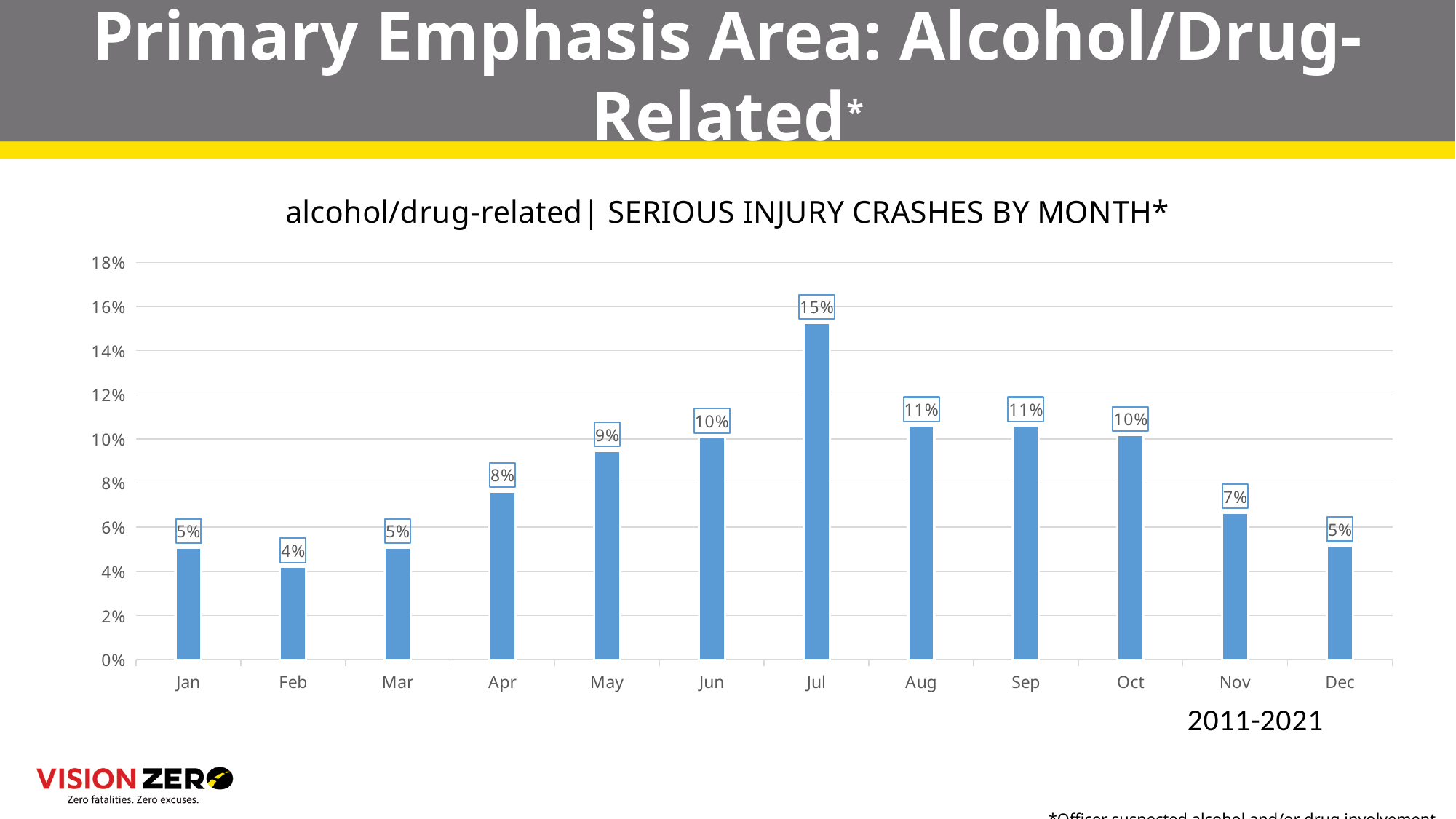
How many months are shown on the x axis? 12 Which month has the lowest value? Feb What time period is noted below the chart? 2011-2021 Is the value for Jul greater or less than 14%? greater What is the value for Oct? 10% Do the values rise or fall from Jan to Jul? rise Which month has the highest value? Jul What kind of chart is shown on the slide? bar chart What is the value for Feb? 4% Which is larger, the value for Apr or the value for Nov? Apr What is the value for Jul? 15% By how many percentage points does Jul exceed Feb? 11